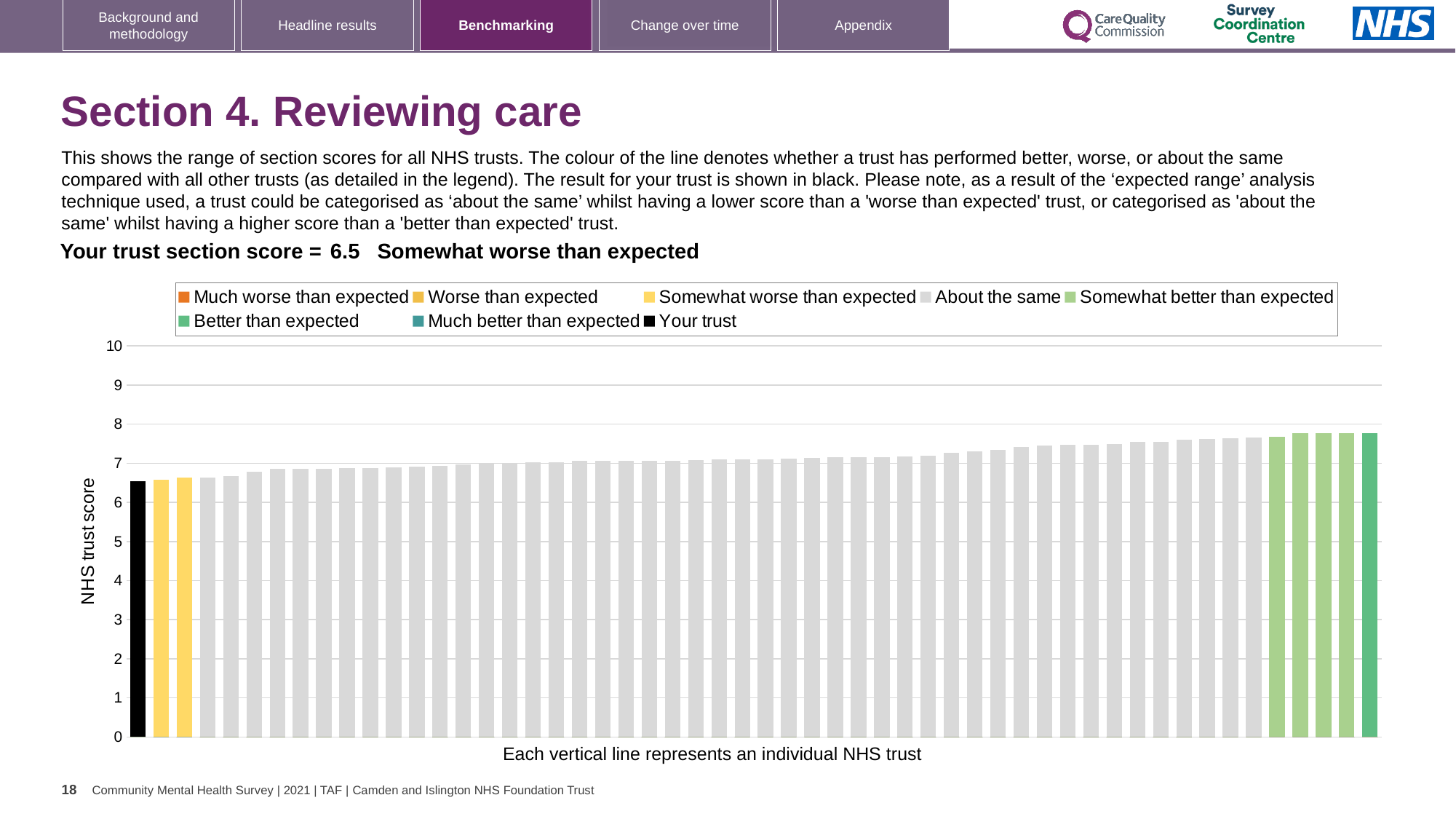
Is the value of the tallest bar greater or less than 8? less How many bars are coloured yellow (Somewhat worse than expected)? 2 What kind of chart is shown on the slide? bar chart Do the bar values rise or fall from left to right along the x axis? rise Which legend category does your trust fall into? Somewhat worse than expected Is the value of the tallest bar greater or less than 7? greater What is the section score for your trust? 6.5 Is the value for your trust (the black bar) greater or less than 7? less What colour is the bar representing your trust? black What is the label on the vertical axis of the chart? NHS trust score How many entries does the chart legend list? 8